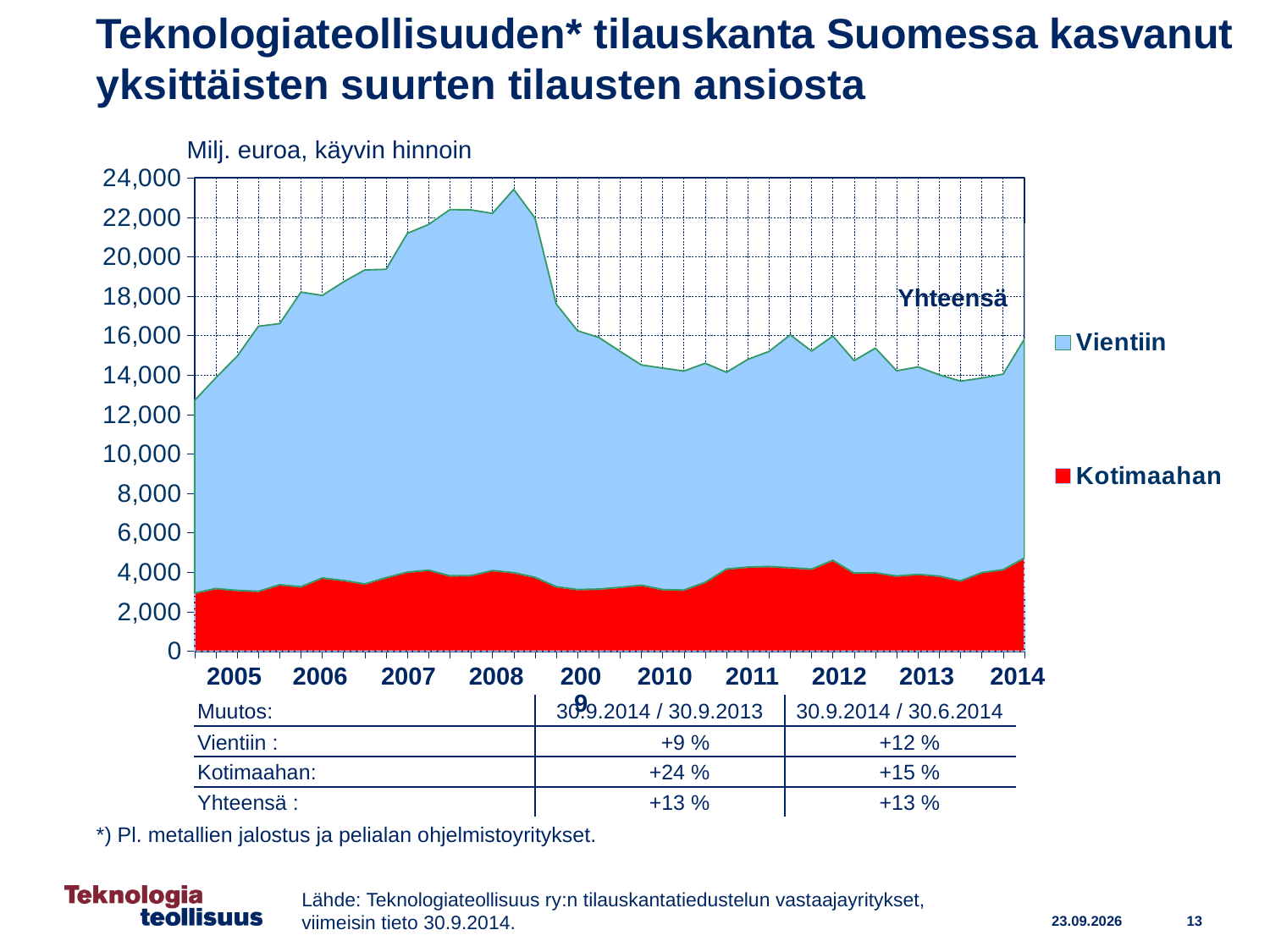
What kind of chart is shown on the slide? area chart Is the total value during 2013 greater or less than 16,000? less Is the peak total value in 2008 greater or less than 22,000? greater Which series is larger throughout the chart, Vientiin or Kotimaahan? Vientiin How many series does the chart's legend list? 2 In which year does the total order backlog (Yhteensä) reach its highest point? 2008 Does the total order backlog rise or fall between 2008 and 2009? fall Is the Kotimaahan value in 2010 greater or less than 4,000? less What are the two series named in the chart's legend? Vientiin and Kotimaahan According to the table below the chart, what is the change for Kotimaahan between 30.9.2013 and 30.9.2014? +24 % What unit label is shown above the chart's y axis? Milj. euroa, käyvin hinnoin